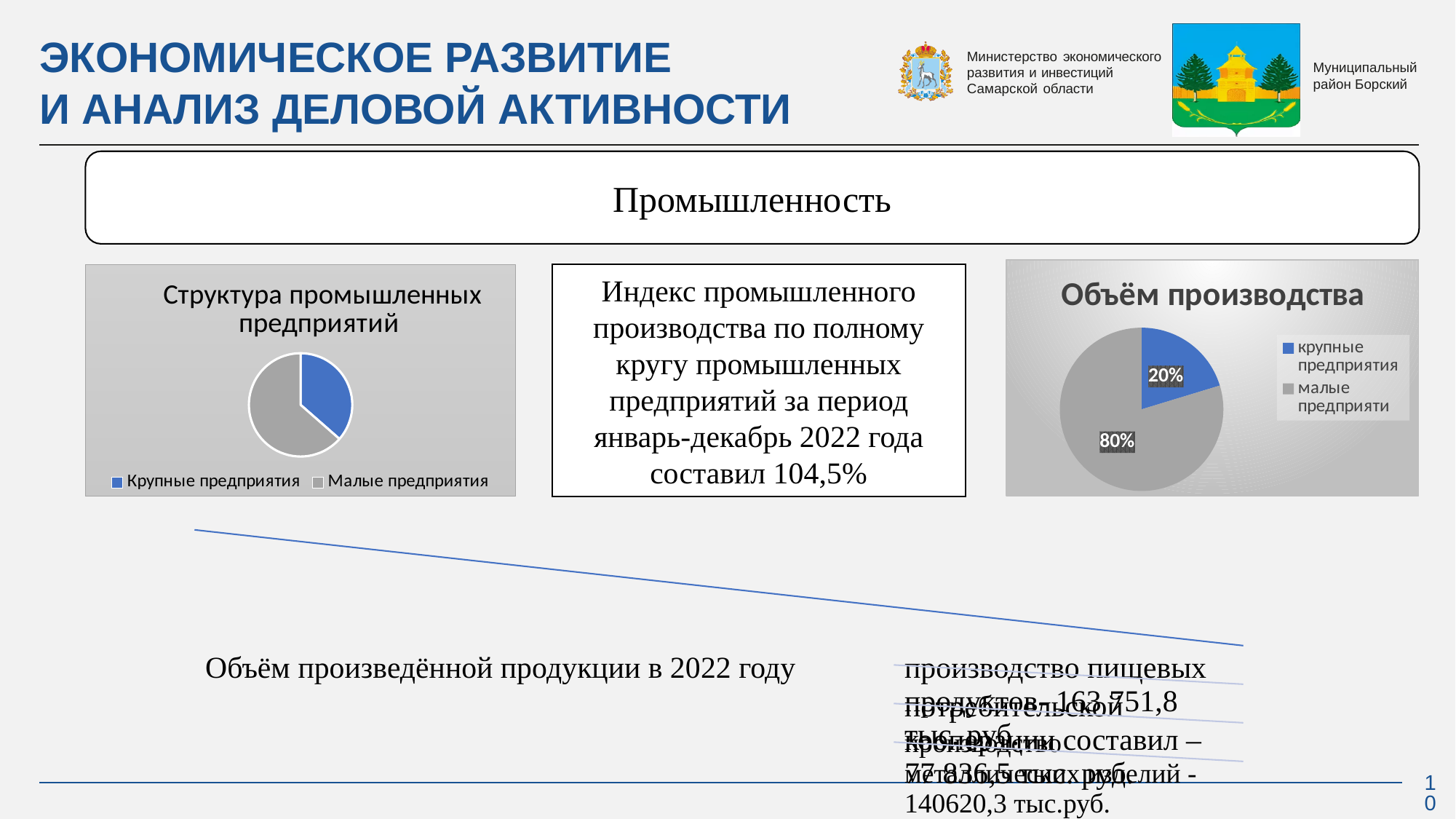
In the "Структура промышленных предприятий" chart, which category has the smallest slice? Крупные предприятия In the "Объём производства" chart, what share is labelled for крупные предприятия? 20% How many categories does the legend of the "Объём производства" chart list? 2 How many categories does the legend of the "Структура промышленных предприятий" chart list? 2 In the "Объём производства" chart, which category has the smallest slice? крупные предприятия What kind of chart is the "Объём производства" chart? pie chart In the "Структура промышленных предприятий" chart, which slice is larger: Крупные предприятия or Малые предприятия? Малые предприятия In the "Объём производства" chart, which category has the largest slice? малые предприяти In the "Структура промышленных предприятий" chart, what colour is the Крупные предприятия slice? blue In the "Объём производства" chart, what is the difference between the shares of малые предприяти and крупные предприятия? 60% In the "Объём производства" chart, what share is labelled for малые предприяти? 80% What kind of chart is the "Структура промышленных предприятий" chart? pie chart